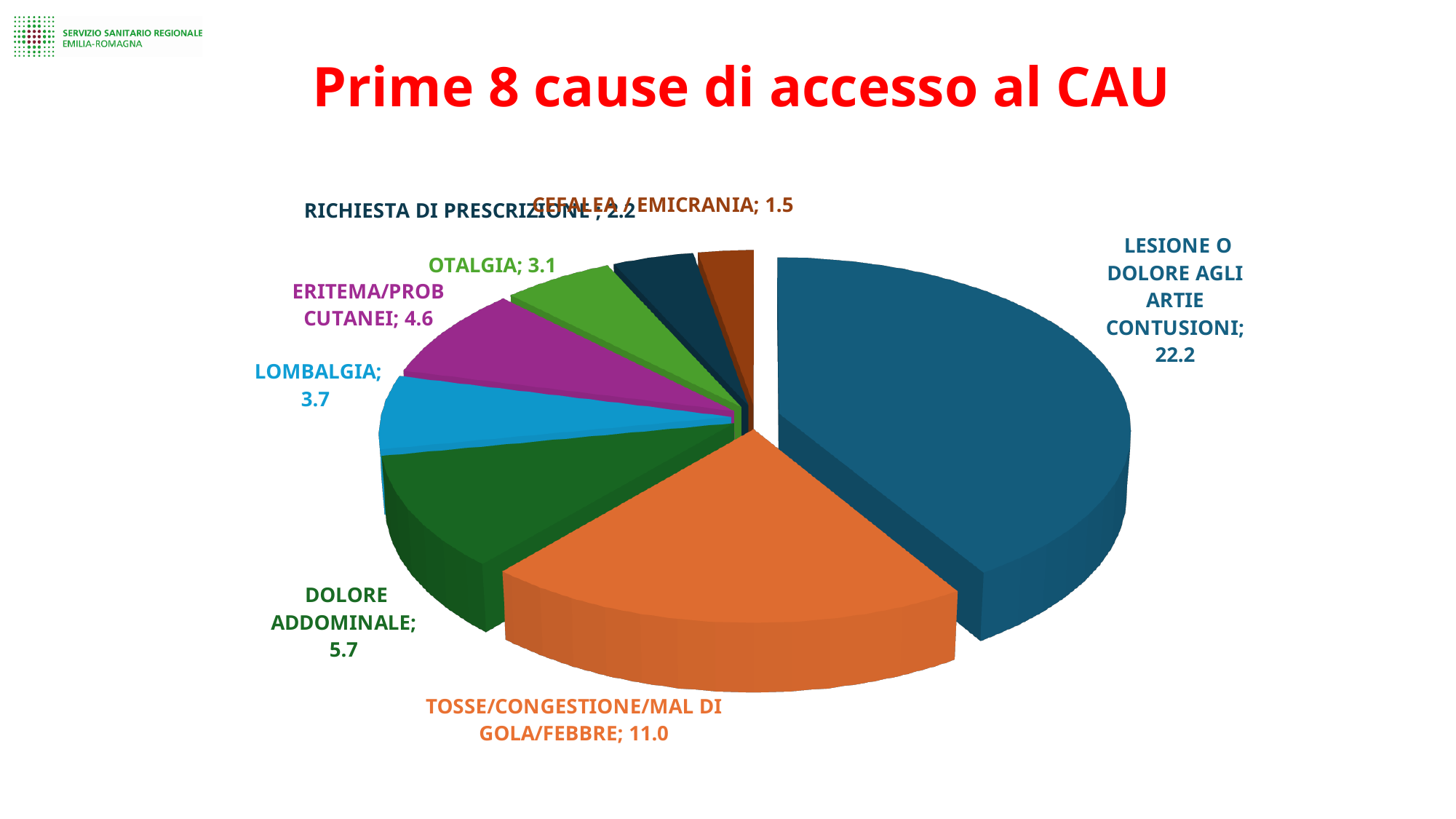
What kind of chart is shown on the slide? Pie chart What is the difference between the values for LESIONE O DOLORE AGLI ARTIE CONTUSIONI and TOSSE/CONGESTIONE/MAL DI GOLA/FEBBRE? 11.2 How many slices does the pie chart have? 8 Which is larger, the value for ERITEMA/PROB CUTANEI or the value for LOMBALGIA? ERITEMA/PROB CUTANEI What is the value for ERITEMA/PROB CUTANEI? 4.6 What is the value for LESIONE O DOLORE AGLI ARTIE CONTUSIONI? 22.2 What is the value for DOLORE ADDOMINALE? 5.7 Which category has the lowest value? CEFALEA / EMICRANIA What is the value for OTALGIA? 3.1 What is the value for LOMBALGIA? 3.7 Which category has the highest value? LESIONE O DOLORE AGLI ARTIE CONTUSIONI What is the value for TOSSE/CONGESTIONE/MAL DI GOLA/FEBBRE? 11.0